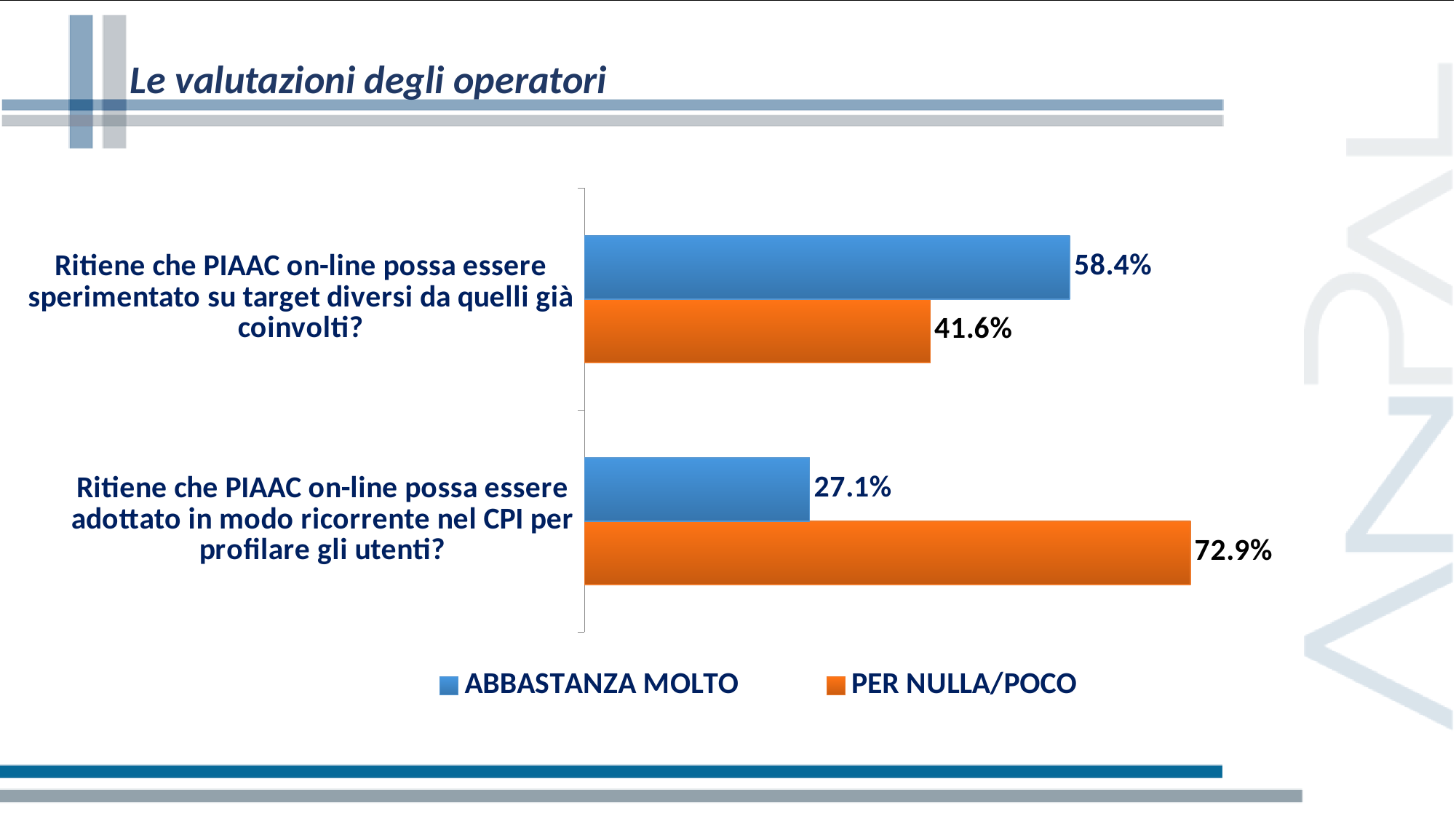
What is the PER NULLA/POCO value for the question about whether PIAAC on-line could be tested on different targets ("sperimentato su target diversi")? 41.6% What is the difference between the PER NULLA/POCO and ABBASTANZA MOLTO values for the question about adopting PIAAC on-line recurrently in the CPI? 45.8% What colour are the PER NULLA/POCO bars? orange How many series does the legend list? 2 For the question about testing PIAAC on-line on different targets, which is larger: ABBASTANZA MOLTO or PER NULLA/POCO? ABBASTANZA MOLTO What is the ABBASTANZA MOLTO value for the question about whether PIAAC on-line could be tested on different targets ("sperimentato su target diversi")? 58.4% How many categories (questions) are shown on the chart? 2 Which bar has the highest value on the chart? PER NULLA/POCO for the question about adopting PIAAC on-line recurrently in the CPI (72.9%) Which bar has the lowest value on the chart? ABBASTANZA MOLTO for the question about adopting PIAAC on-line recurrently in the CPI (27.1%) What is the ABBASTANZA MOLTO value for the question about adopting PIAAC on-line recurrently in the CPI to profile users? 27.1% What kind of chart is shown on the slide? bar chart What is the PER NULLA/POCO value for the question about adopting PIAAC on-line recurrently in the CPI to profile users? 72.9%